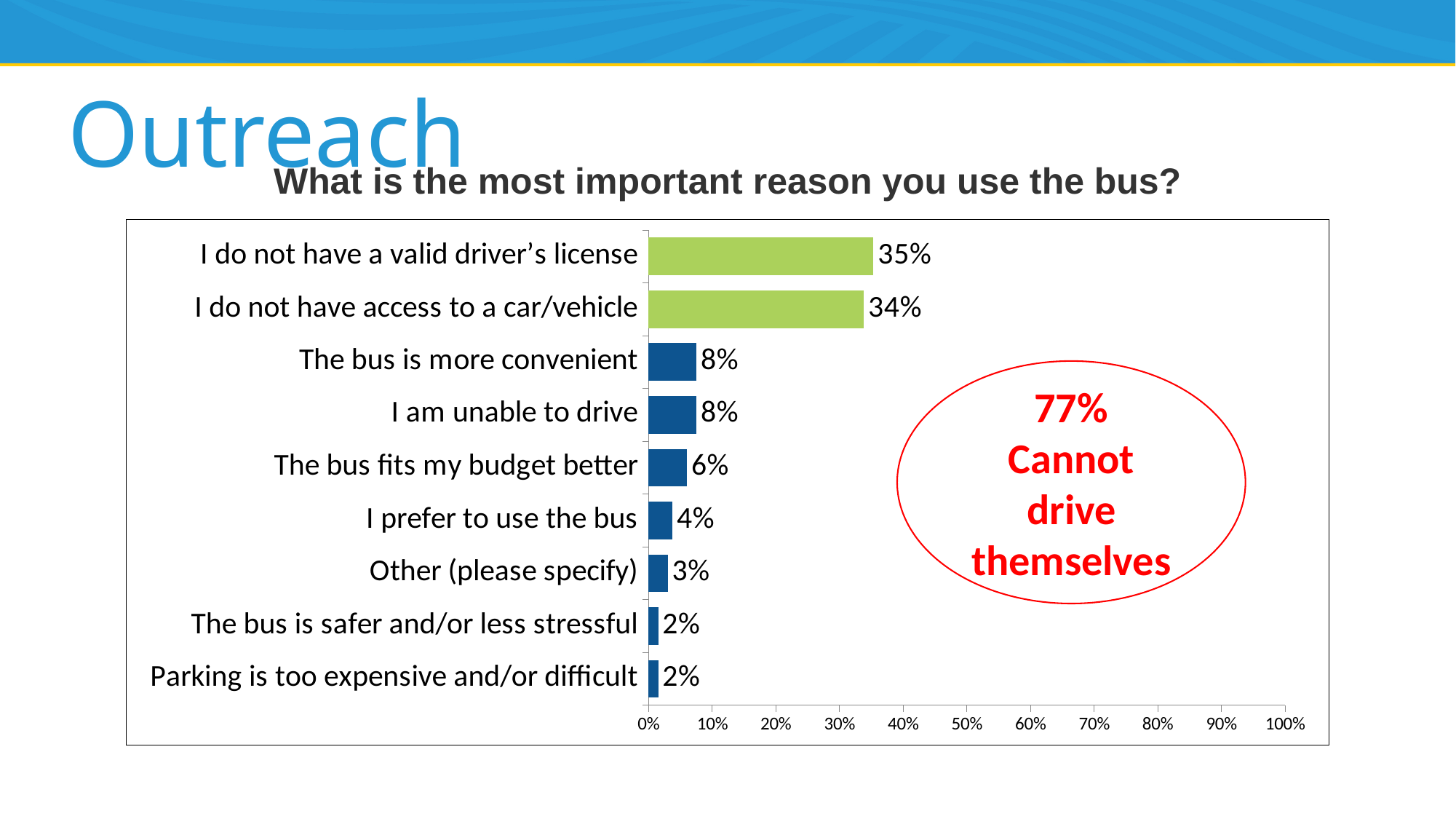
What percentage of respondents said "I do not have a valid driver's license"? 35% Which is larger: "I do not have access to a car/vehicle" or "I am unable to drive"? I do not have access to a car/vehicle What is the value for "The bus fits my budget better"? 6% What is the combined total of the two green bars? 69% What does the red circled annotation on the chart say? 77% Cannot drive themselves What is the difference between "The bus is more convenient" and "Other (please specify)"? 5% How many reasons (categories) are shown in the chart? 9 What type of chart is shown on the slide? bar chart What is the difference between "I do not have a valid driver's license" and "I do not have access to a car/vehicle"? 1% Is the value for "I do not have a valid driver's license" greater or less than 30%? greater What is the value for "I prefer to use the bus"? 4% Which reason has the highest percentage? I do not have a valid driver's license